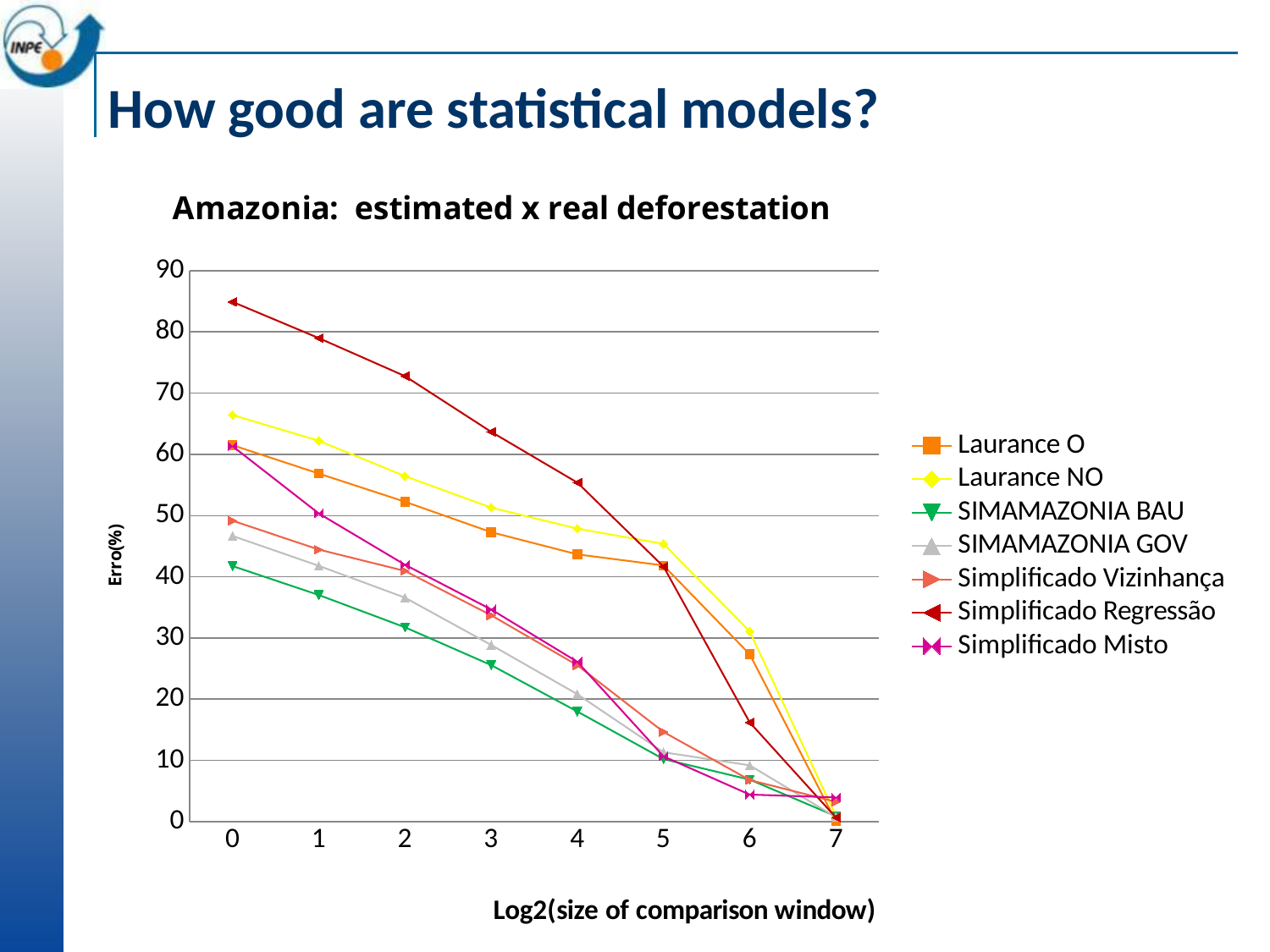
Is the value for SIMAMAZONIA BAU at x = 0 greater or less than 50? less How many series does the legend list? 7 What kind of chart is shown on the slide? line chart Is the value for Laurance NO at x = 5 greater or less than 40? greater At x = 2, which is larger: Laurance NO or Laurance O? Laurance NO Is the value for Simplificado Regressão at x = 6 greater or less than 20? less Do the values of the series rise or fall as the x axis increases from 0 to 7? fall What is the title of the chart? Amazonia: estimated x real deforestation Which series has the lowest value at x = 0? SIMAMAZONIA BAU Which series has the highest value at x = 0? Simplificado Regressão How many points along the x axis does each series have? 8